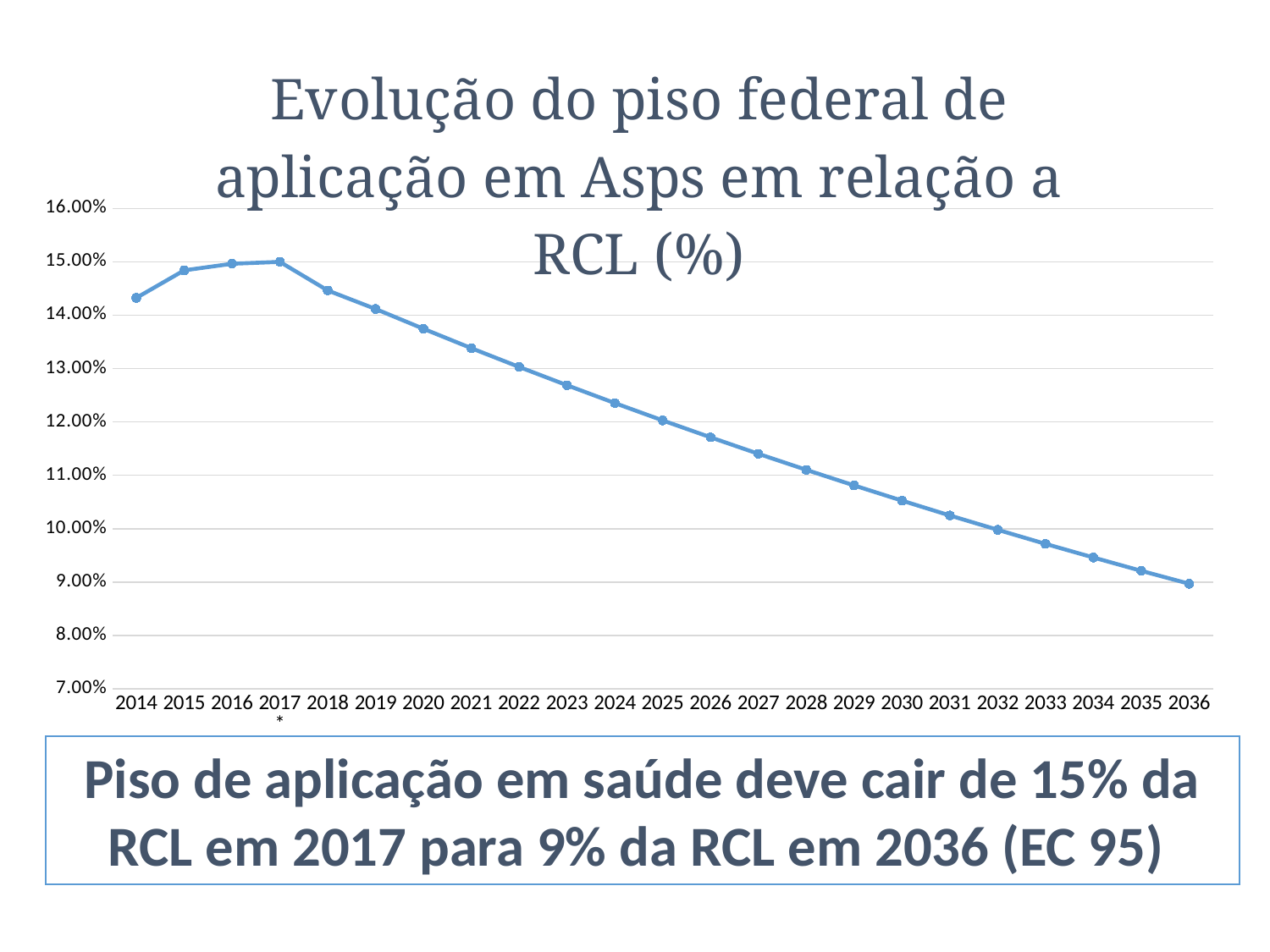
Is the value for 2033 greater or less than 10.00%? less What is the title of the chart? Evolução do piso federal de aplicação em Asps em relação a RCL (%) Is the value for 2024 greater or less than 12.00%? greater Which year has the larger value, 2015 or 2020? 2015 Is the value for 2014 greater or less than 14.00%? greater Do the values rise or fall along the x axis from 2017 to 2036? fall What kind of chart is shown on the slide? line chart Do the values rise or fall along the x axis from 2014 to 2017? rise How many years are plotted on the x axis of the chart? 23 Which year has the highest value in the chart? 2017 Which year has the lowest value in the chart? 2036